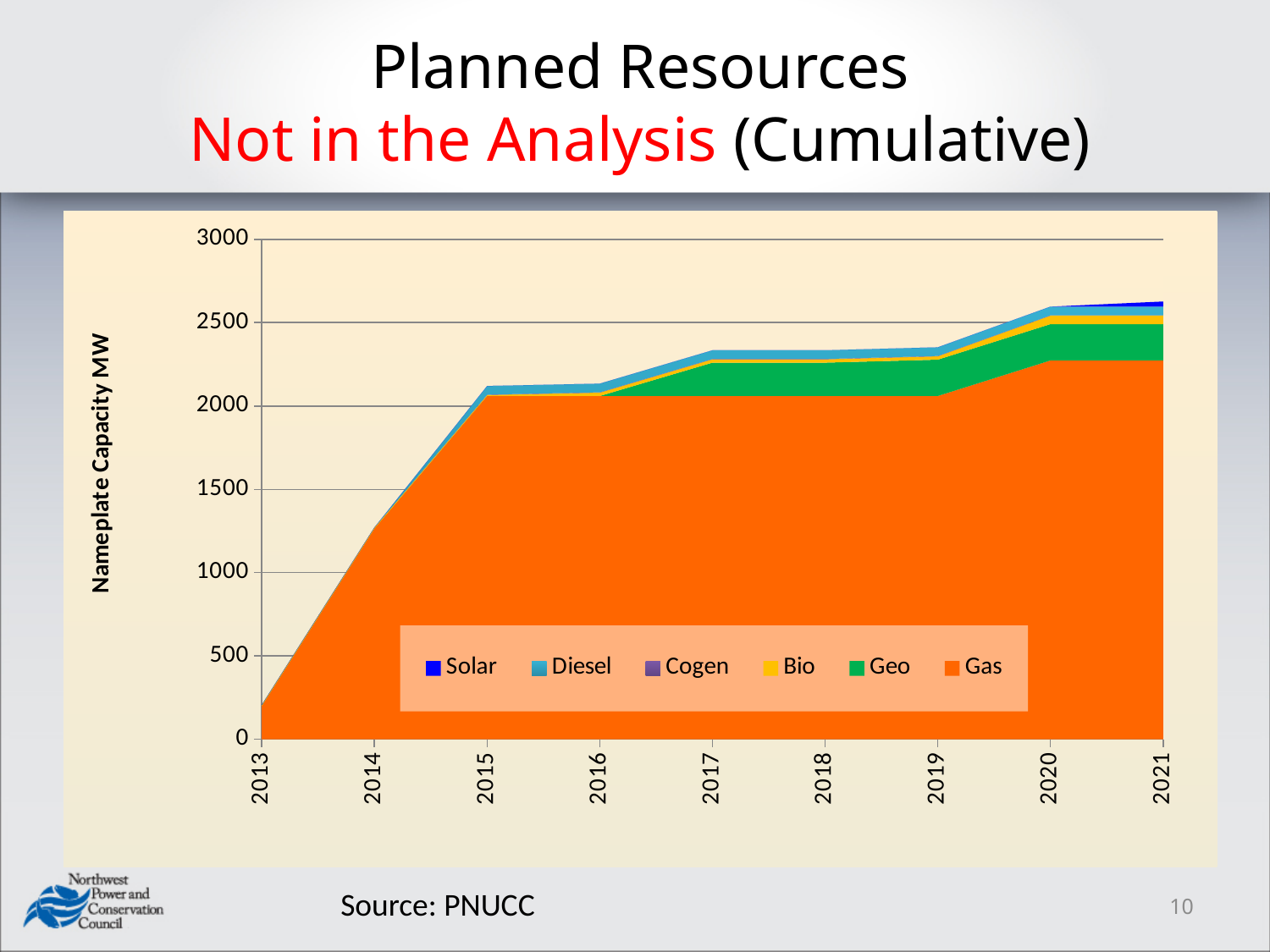
How many years are shown along the x axis? 9 Does the total cumulative capacity rise or fall from 2013 to 2021? Rise How many series does the legend list? 6 Is the total cumulative capacity in 2021 greater or less than 2500 MW? greater Is the Gas capacity in 2013 greater or less than 500 MW? less Which year has the lowest total cumulative capacity? 2013 Is the total cumulative capacity in 2017 greater or less than 2500 MW? less What is the label on the vertical axis? Nameplate Capacity MW Which resource type accounts for the largest share of the cumulative capacity? Gas Which year has the highest total cumulative capacity? 2021 What kind of chart is shown on the slide? Stacked area chart